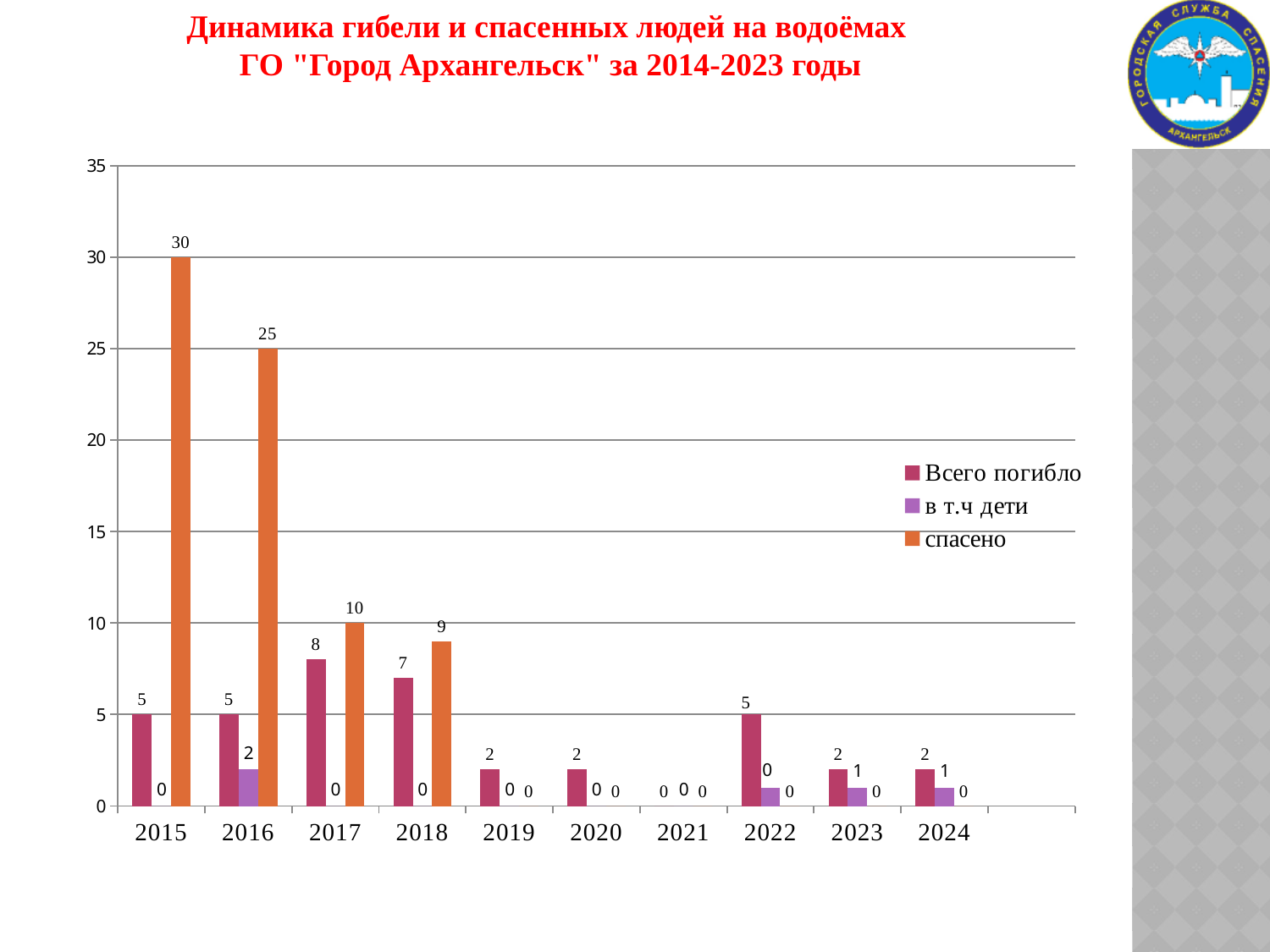
In which year is the "спасено" value highest? 2015 How many years are shown on the x axis? 10 Which series is shown in orange in the legend? спасено In which year is the "Всего погибло" value highest? 2017 What is the value of "спасено" for 2015? 30 What is the difference between the "спасено" values for 2015 and 2016? 5 Which is larger: "Всего погибло" in 2018 or in 2022? 2018 What is the value of "Всего погибло" for 2017? 8 What is the value of "в т.ч дети" for 2016? 2 How many series does the legend list? 3 What kind of chart is shown on the slide? bar chart Does the "спасено" value generally rise or fall from 2015 to 2019? fall